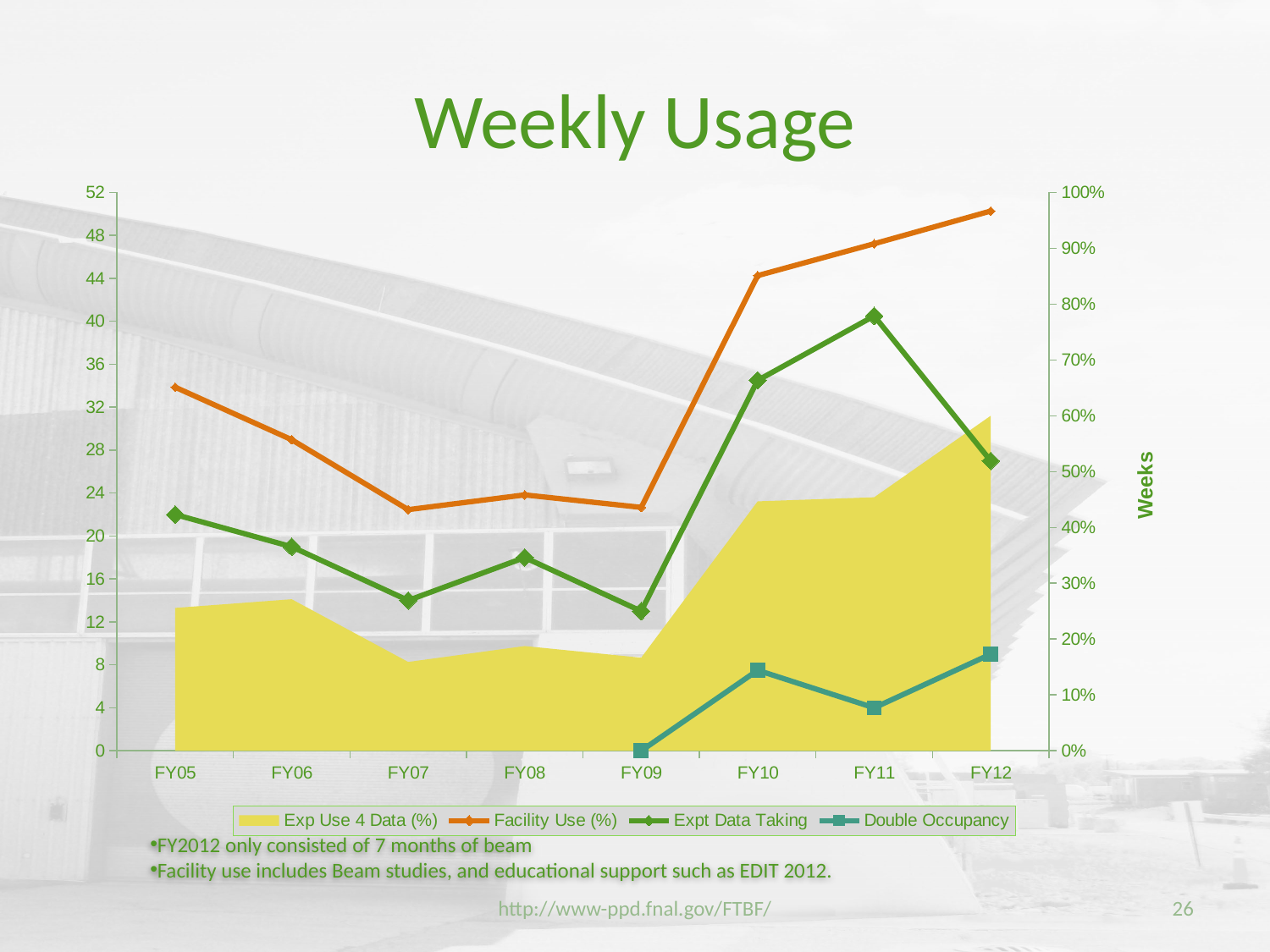
What is the label on the right-hand vertical axis? Weeks Which is higher in FY10, Facility Use (%) or Expt Data Taking? Facility Use (%) Is the Facility Use (%) value for FY12 greater or less than 90%? greater Does Facility Use (%) rise or fall from FY09 to FY12? rise In which fiscal year is Facility Use (%) highest? FY12 In which fiscal year is Double Occupancy lowest? FY09 What is the Double Occupancy value in FY09? 0 What is the title of the chart? Weekly Usage Is the Facility Use (%) value for FY09 greater or less than 50%? less In which fiscal year is Expt Data Taking highest? FY11 How many series does the legend list? 4 How many fiscal years are shown on the x axis? 8